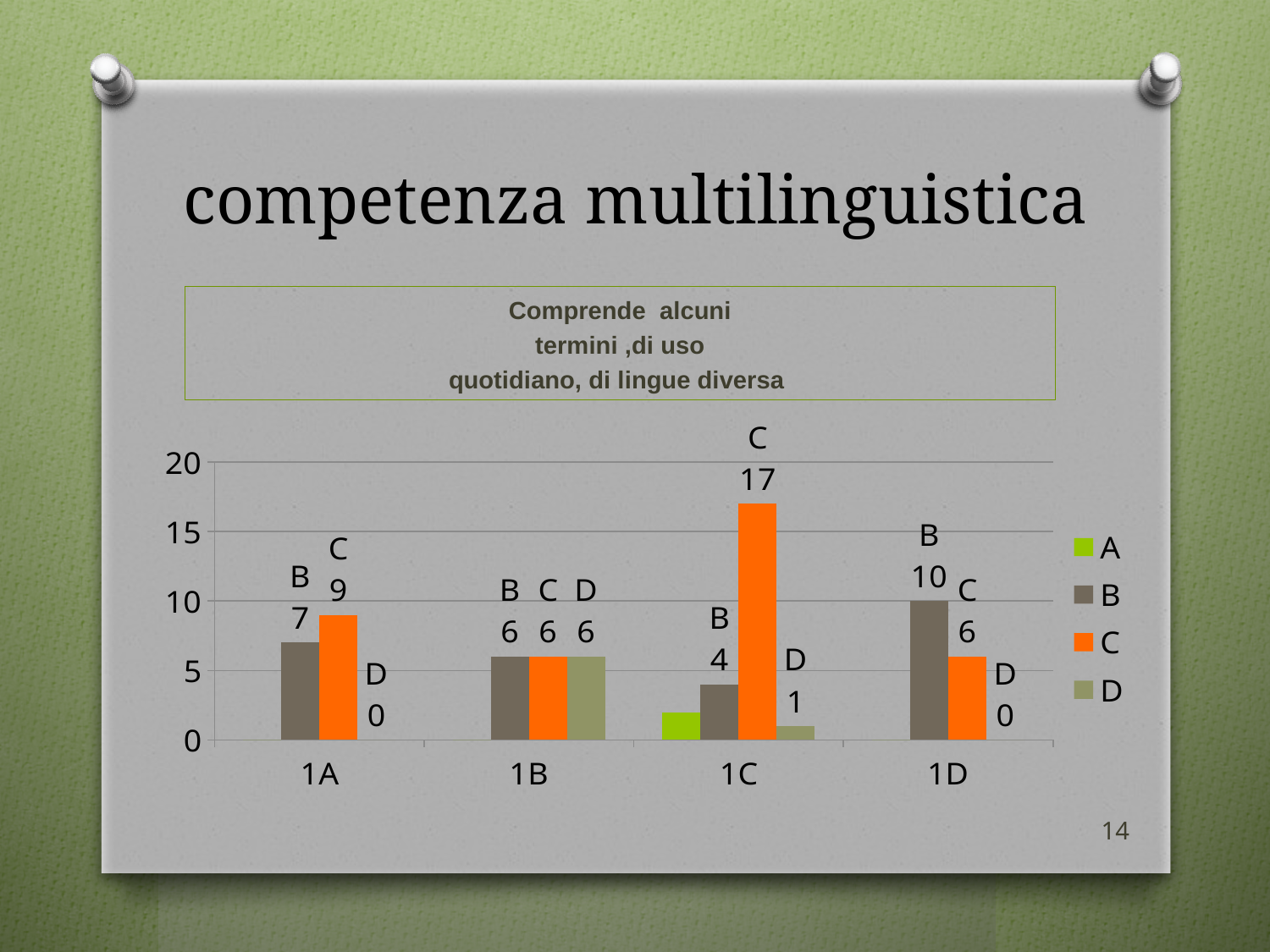
How many series does the legend list? 4 Which category has the highest value for series C? 1C What kind of chart is shown on the slide? bar chart What is the value of series C for category 1C? 17 What colour represents series C in the legend? orange How many categories are shown on the x axis? 4 What is the difference between series C and series B for category 1C? 13 Which is larger for category 1A: series B or series C? C Which category has the lowest value for series B? 1C What is the value of series B for category 1D? 10 Is the value of series A for category 1C greater or less than 5? less What is the value of series D for category 1B? 6